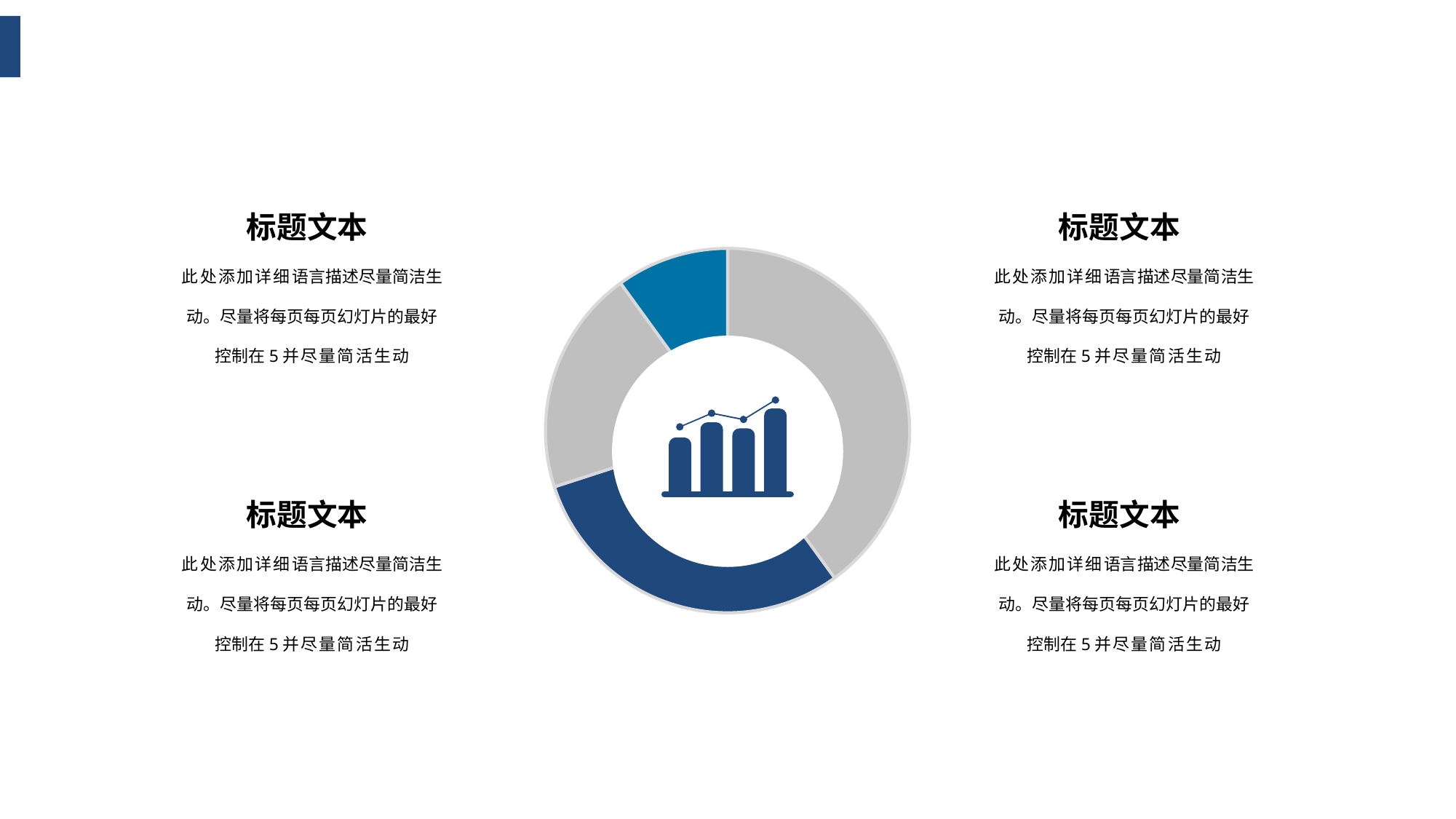
What kind of chart is shown in the centre of the slide? Donut (pie) chart How many slices does the donut chart have? 4 Which is larger in the donut chart, the dark blue slice or the light blue slice? The dark blue slice What is drawn inside the hole of the donut chart? A bar-and-line chart icon Which slice of the donut chart is the smallest? The light blue slice at the top left Which slice of the donut chart is the largest? The light gray slice on the right Does the donut chart show any data labels or a legend? No